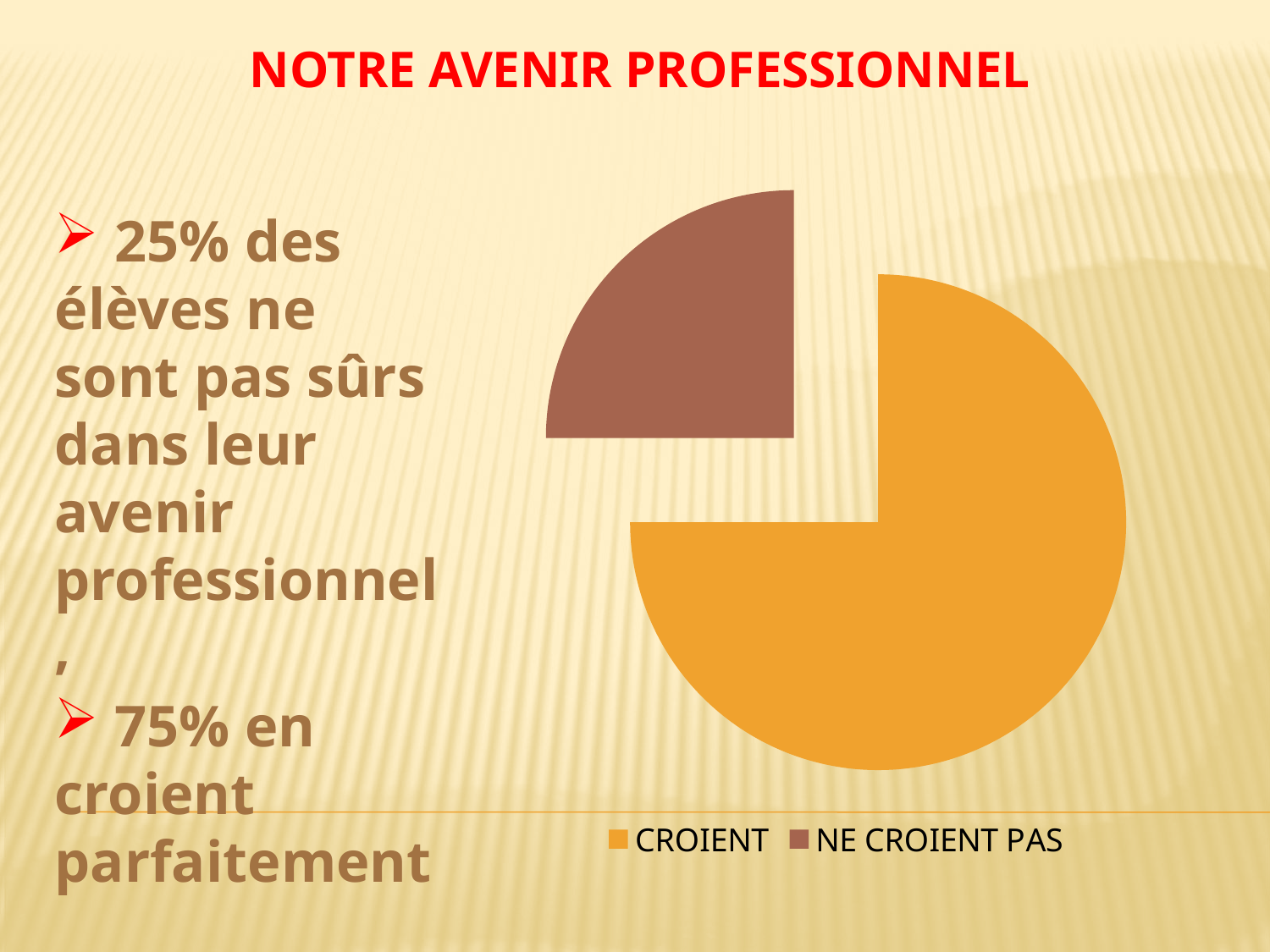
Which slice of the pie chart is the smallest? NE CROIENT PAS What share of the pie does the CROIENT slice represent? 75% What colour is the NE CROIENT PAS slice in the pie chart? brown Which is larger in the pie chart, CROIENT or NE CROIENT PAS? CROIENT What share of the pie does the NE CROIENT PAS slice represent? 25% How many entries does the legend of the pie chart list? 2 Which slice of the pie chart is the largest? CROIENT What kind of chart is shown on the slide? pie chart What colour is the CROIENT slice in the pie chart? orange How many slices does the pie chart have? 2